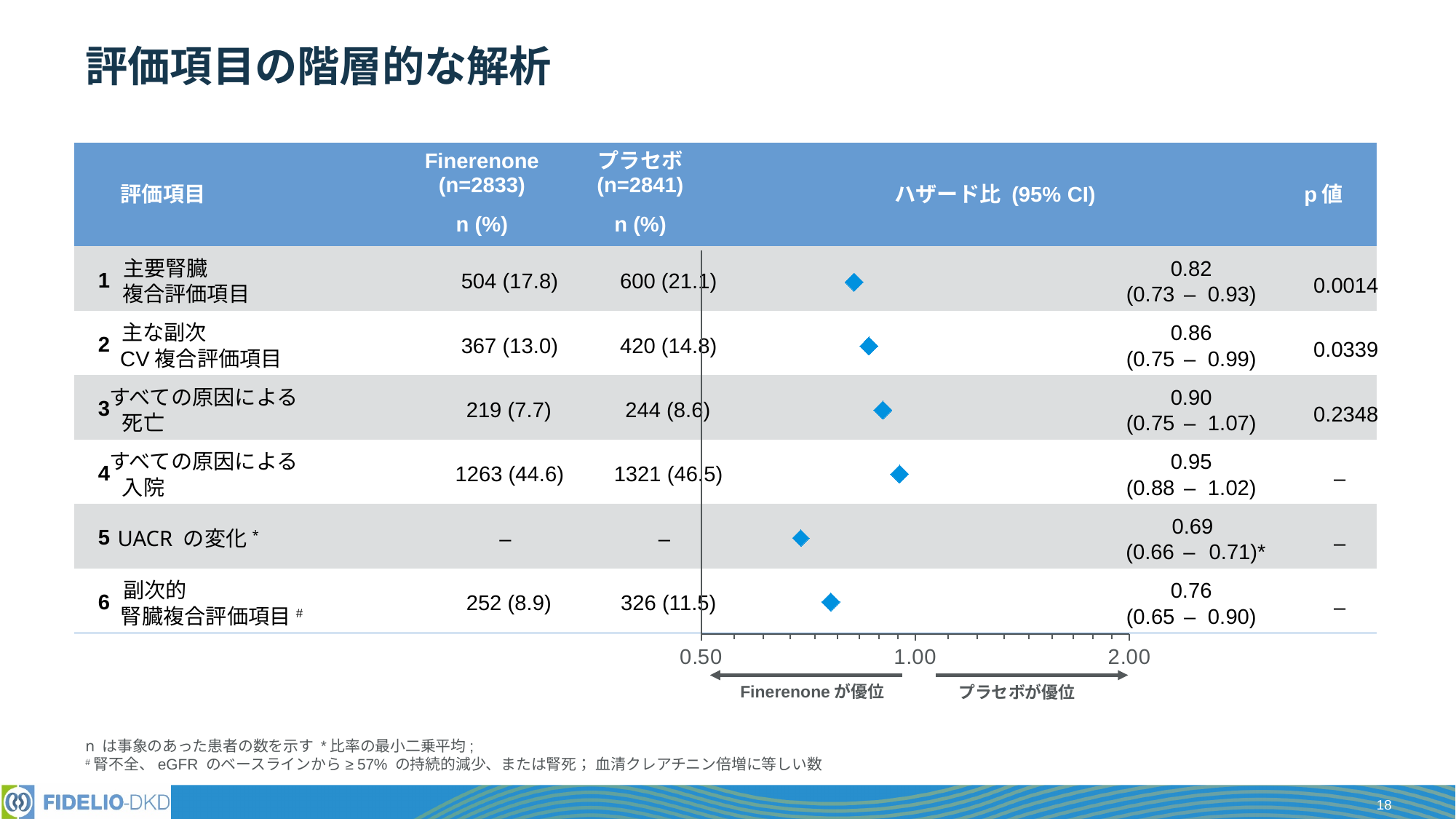
Is the hazard ratio for すべての原因による入院 greater or less than 1.00? less Which endpoint has the lowest hazard ratio in the forest plot? UACR の変化 What is the difference between the hazard ratio for すべての原因による入院 (0.95) and for UACR の変化 (0.69)? 0.26 What kind of chart is shown on the slide? Forest plot What is the 95% CI shown for UACR の変化 (row 5)? (0.66 – 0.71)* What is the hazard ratio plotted for 主要腎臓複合評価項目 (row 1)? 0.82 How many endpoints (rows) are plotted in the forest plot? 6 Which endpoint has the highest hazard ratio in the forest plot? すべての原因による入院 What is the hazard ratio for 副次的腎臓複合評価項目 (row 6)? 0.76 What is the p value shown for 主な副次 CV 複合評価項目? 0.0339 Which has the larger hazard ratio: 主な副次 CV 複合評価項目 or すべての原因による死亡? すべての原因による死亡 What label appears under the left arrow below the hazard ratio axis? Finerenone が優位